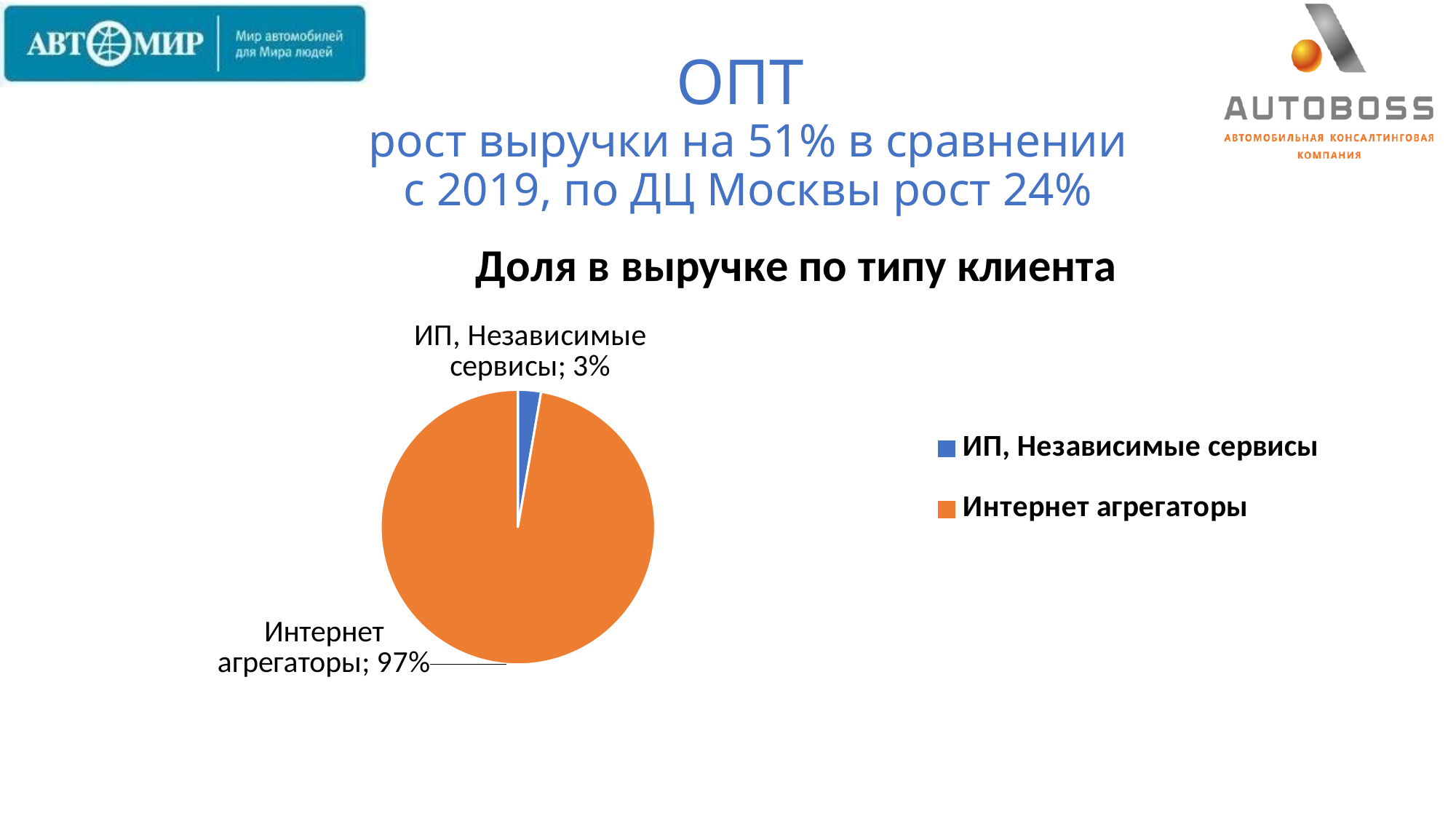
What is the title of the chart? Доля в выручке по типу клиента How many entries does the legend list? 2 What share of revenue comes from Интернет агрегаторы? 97% What kind of chart is shown on the slide? pie chart How many slices does the pie chart have? 2 Which client type has the largest share of revenue? Интернет агрегаторы Which has a larger share of revenue: ИП, Независимые сервисы or Интернет агрегаторы? Интернет агрегаторы What share of revenue comes from ИП, Независимые сервисы? 3% Which client type has the smallest share of revenue? ИП, Независимые сервисы What is the difference in percentage points between the share of Интернет агрегаторы and ИП, Независимые сервисы? 94 What colour is the slice for Интернет агрегаторы? orange